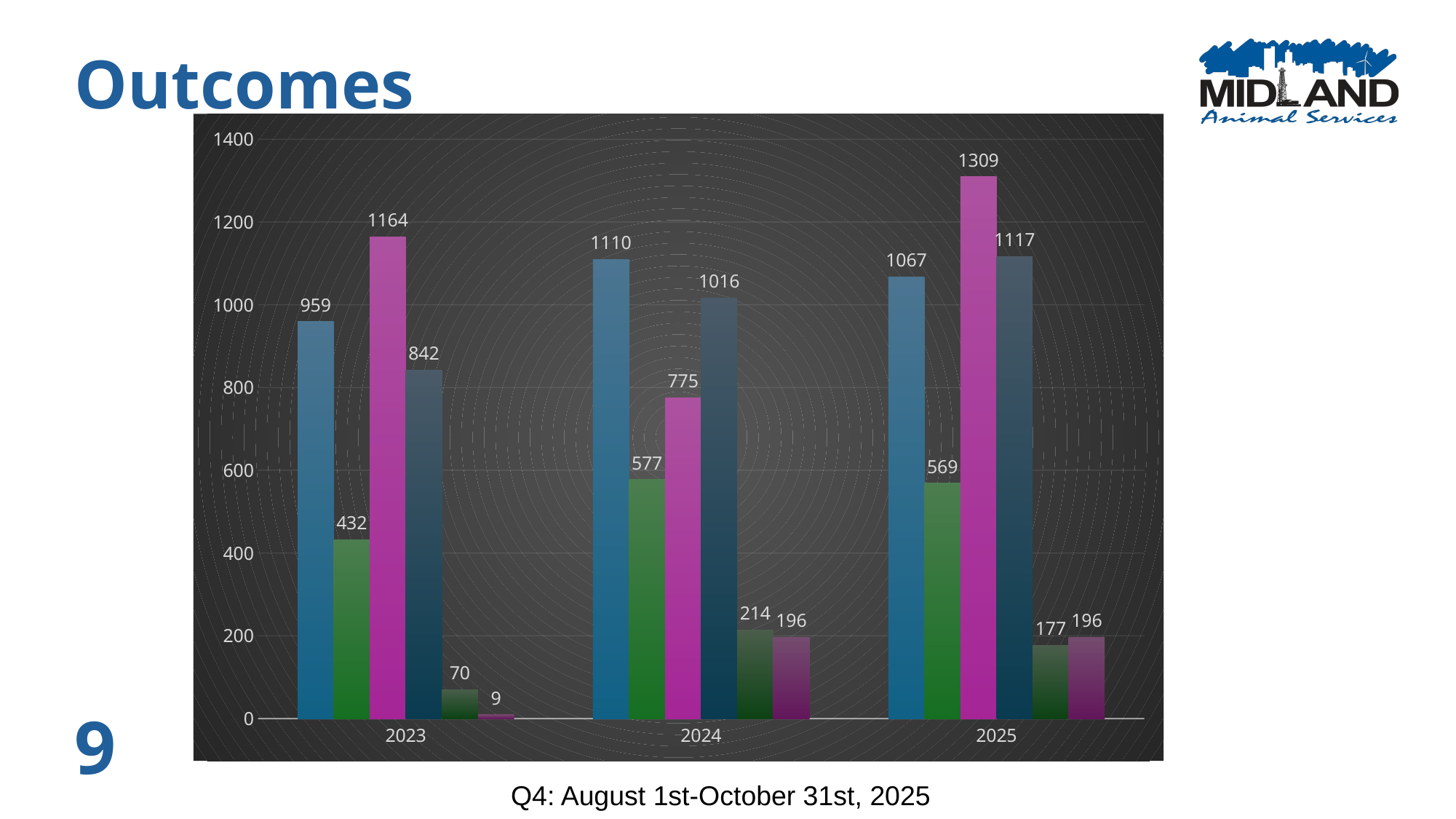
What is the value of the dark green (fifth) bar for 2024? 214 What is the value of the first (light blue) bar for 2024? 1110 What type of chart is shown on the slide? bar chart Which is larger, the green (second) bar for 2024 or the green bar for 2025? 2024 What is the title of the slide containing the chart? Outcomes Is the value of the dark blue (fourth) bar for 2023 greater or less than 1000? less How many bars are plotted for each year? 6 How many year categories are shown on the x axis? 3 What is the value of the magenta (third) bar for 2025? 1309 Which year has the highest single bar value on the chart? 2025 What is the difference between the magenta bar values for 2025 and 2024? 534 What is the value of the smallest bar for 2023? 9